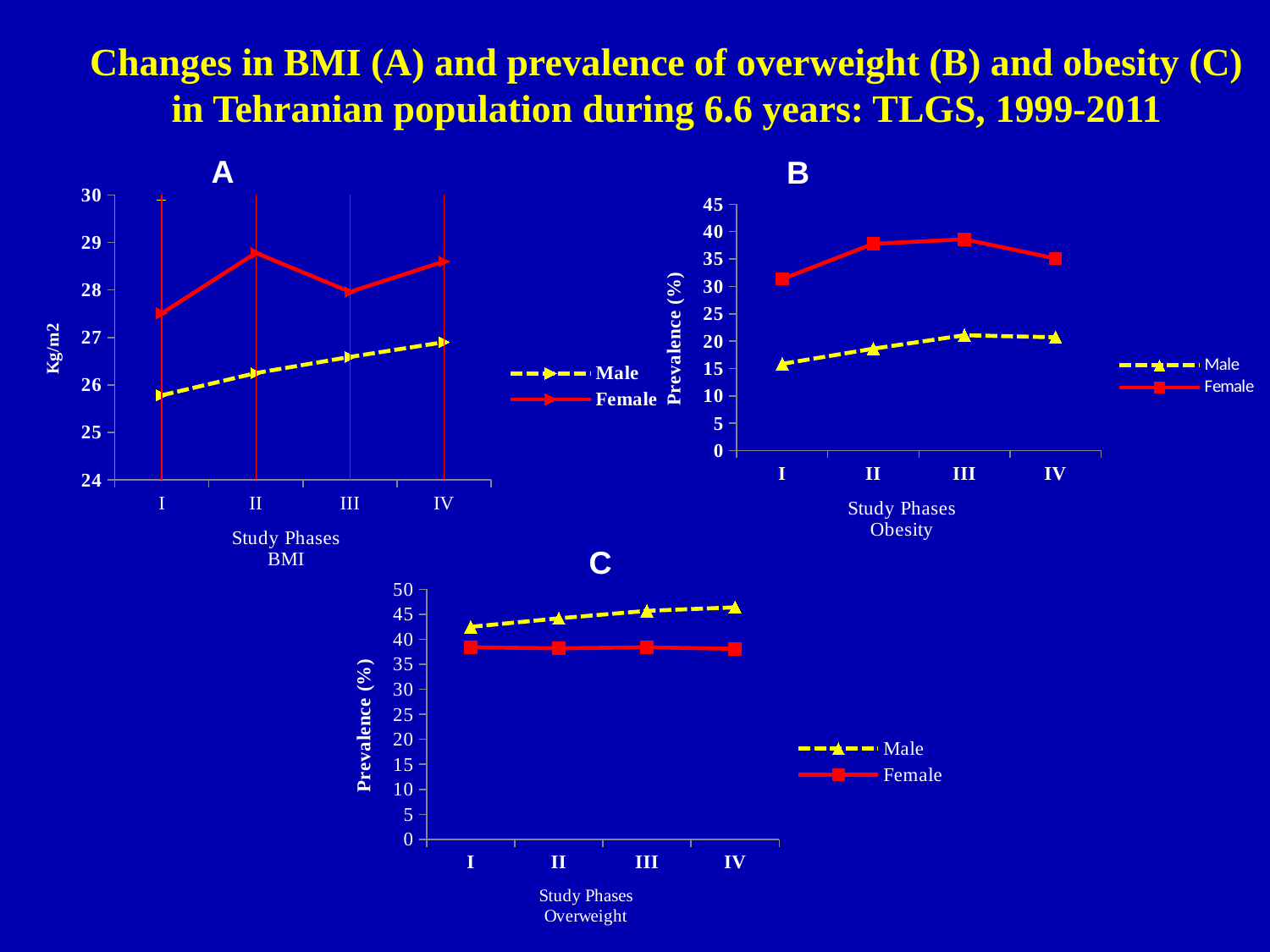
In chart A (BMI), is the Female value at phase II greater or less than 28? greater What kind of chart is chart A (BMI)? line chart In chart A (BMI), does the Male series rise or fall from phase I to phase IV? rise In chart B (Obesity), which series is higher at phase II, Male or Female? Female In chart C (Overweight), which series is higher at phase I, Male or Female? Male In chart B (Obesity), is the Female value at phase I greater or less than 30? greater How many series does the legend of chart B (Obesity) list? 2 In chart A (BMI), is the Male value at phase I greater or less than 26? less How many study phases are plotted on the x axis of chart C (Overweight)? 4 What is the y-axis label of chart B (Obesity)? Prevalence (%) In chart A (BMI), which series is higher at phase III, Male or Female? Female